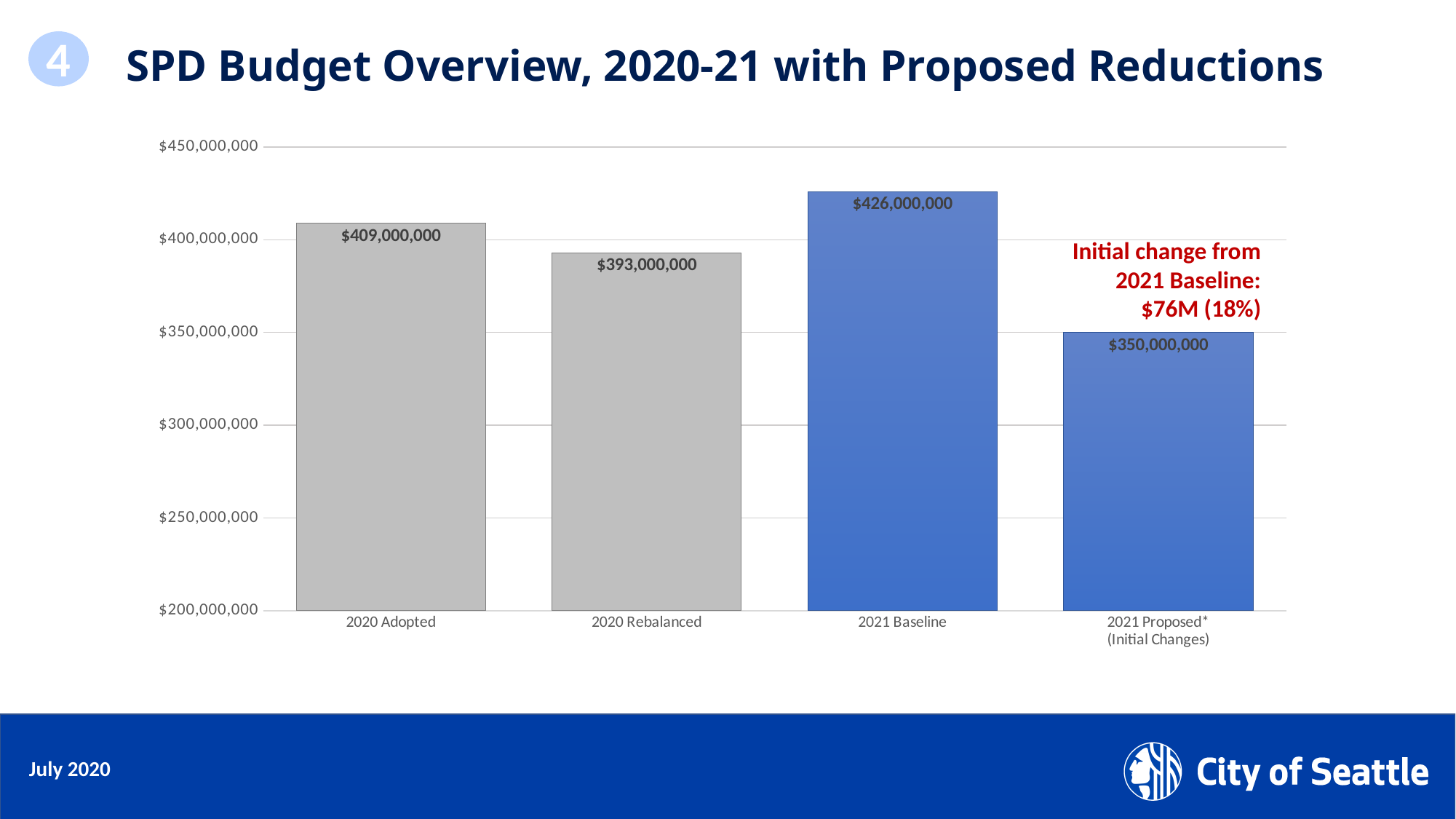
Which category has the highest value? 2021 Baseline What is the difference between the 2021 Baseline and 2021 Proposed* (Initial Changes) values? $76,000,000 What is the value for 2021 Proposed* (Initial Changes)? $350,000,000 How many categories are shown on the x axis? 4 Which is larger, the value for 2020 Adopted or the value for 2020 Rebalanced? 2020 Adopted What kind of chart is shown on the slide? Bar chart Which category has the lowest value? 2021 Proposed* (Initial Changes) What is the value for 2021 Baseline? $426,000,000 What is the value for 2020 Rebalanced? $393,000,000 What is the difference between the 2020 Adopted and 2020 Rebalanced values? $16,000,000 What is the title of the chart on the slide? SPD Budget Overview, 2020-21 with Proposed Reductions What is the value for 2020 Adopted? $409,000,000